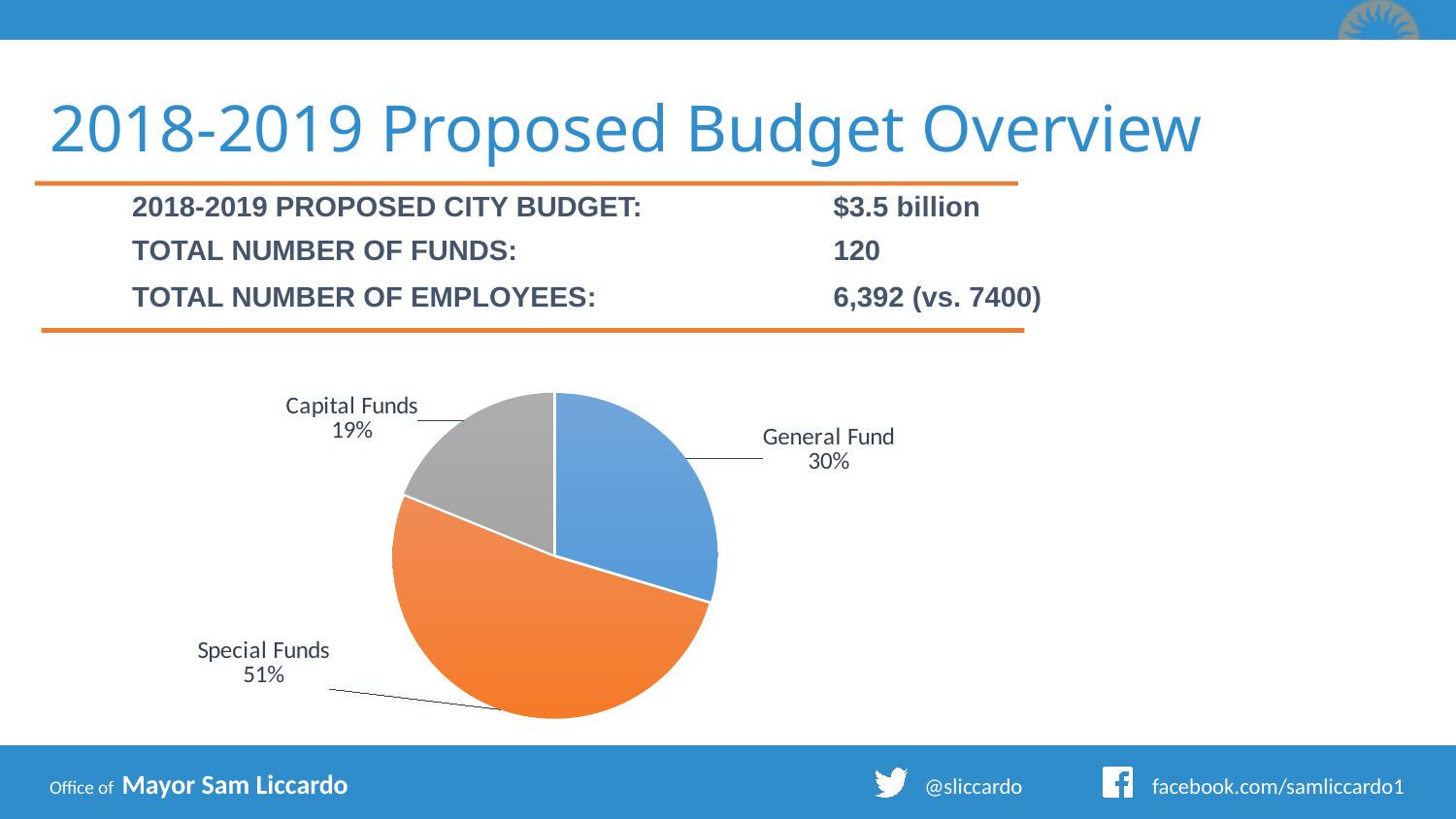
Which is larger, the General Fund slice or the Capital Funds slice? General Fund What colour is the Special Funds slice? orange How many slices does the pie chart have? 3 Which slice of the pie is the largest? Special Funds What is the difference in percentage points between Special Funds and General Fund? 21 What share of the pie does Capital Funds represent? 19% What share of the pie does the General Fund represent? 30% What colour is the Capital Funds slice? gray What is the difference in percentage points between General Fund and Capital Funds? 11 What type of chart is shown on the slide? pie chart What share of the pie does Special Funds represent? 51% Which slice of the pie is the smallest? Capital Funds